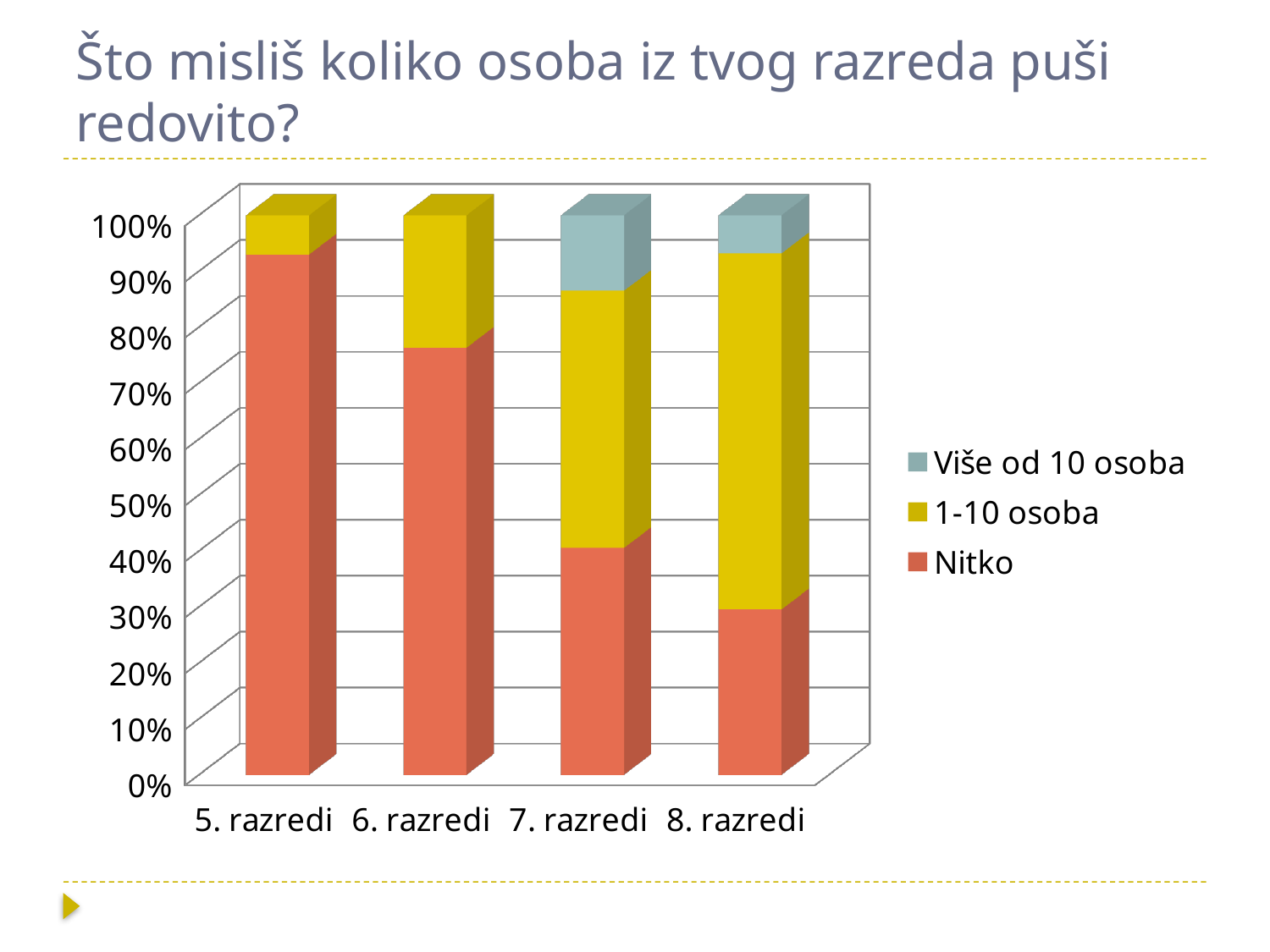
Does the 'Nitko' share rise or fall from 5. razredi to 8. razredi? fall Is the 'Nitko' share for 7. razredi greater or less than 50%? less What kind of chart is shown on the slide? bar chart Is the 'Nitko' share for 8. razredi greater or less than 40%? less Is the 'Nitko' share for 6. razredi greater or less than 70%? greater How many series does the legend list? 3 Which legend entry is shown in red/orange? Nitko How many categories (classes) are shown on the x axis? 4 Which class has the largest share for 'Nitko'? 5. razredi Which class has the smallest share for 'Nitko'? 8. razredi Which is larger, the 'Nitko' share for 6. razredi or for 7. razredi? 6. razredi